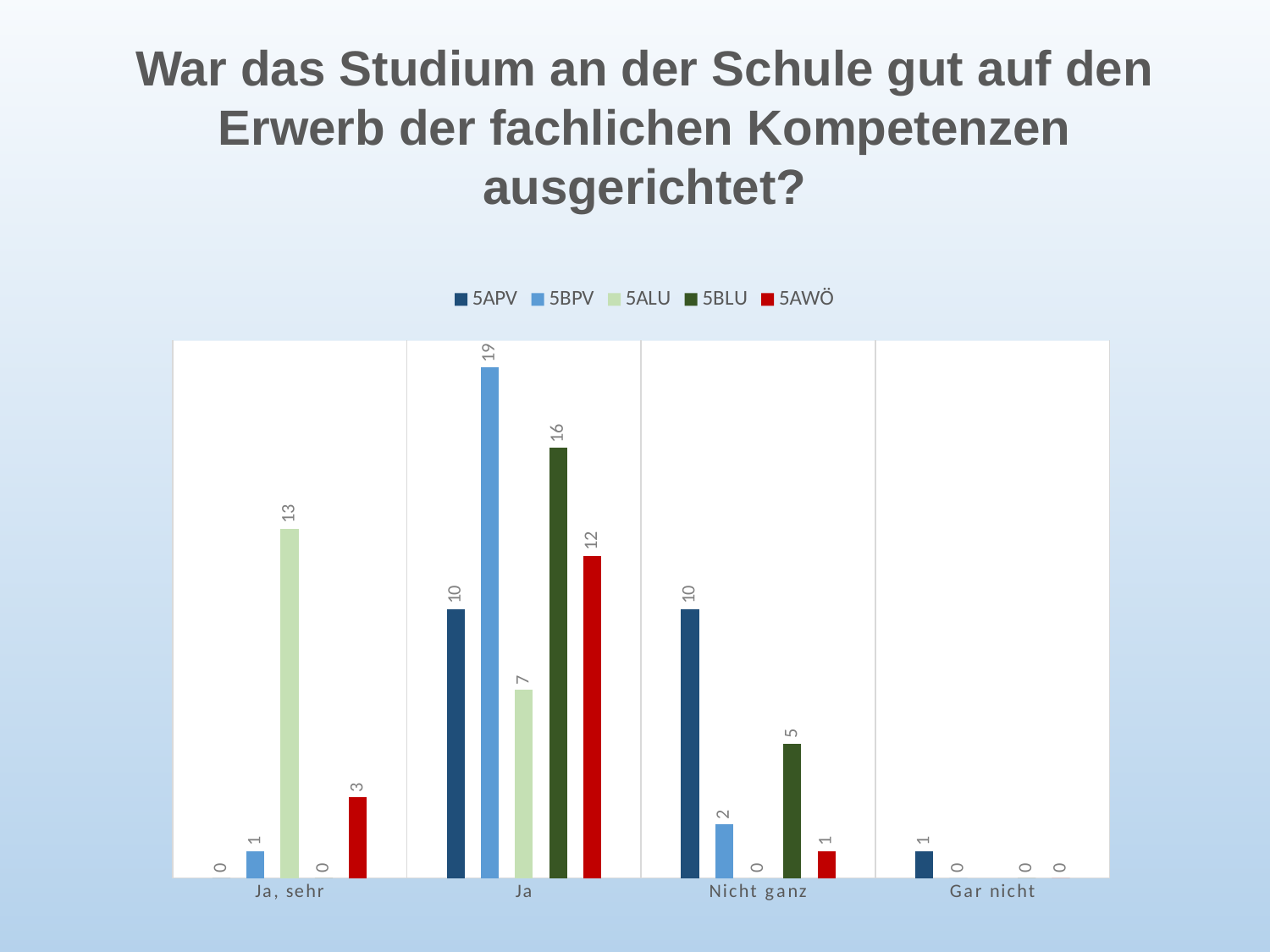
What is the value for 5ALU in the 'Ja, sehr' category? 13 How many categories are shown on the x axis? 4 What is the value for 5BLU in the 'Nicht ganz' category? 5 What kind of chart is shown on the slide? bar chart In the 'Nicht ganz' category, which is larger: the value for 5APV or the value for 5BLU? 5APV What is the value for 5BPV in the 'Ja' category? 19 What is the value for 5AWÖ in the 'Ja' category? 12 Which series has the highest value in the 'Ja, sehr' category? 5ALU What is the difference between the 5BPV and 5BLU values in the 'Ja' category? 3 Which series is shown in red in the legend? 5AWÖ Which series has the highest value in the 'Ja' category? 5BPV How many series does the legend list? 5